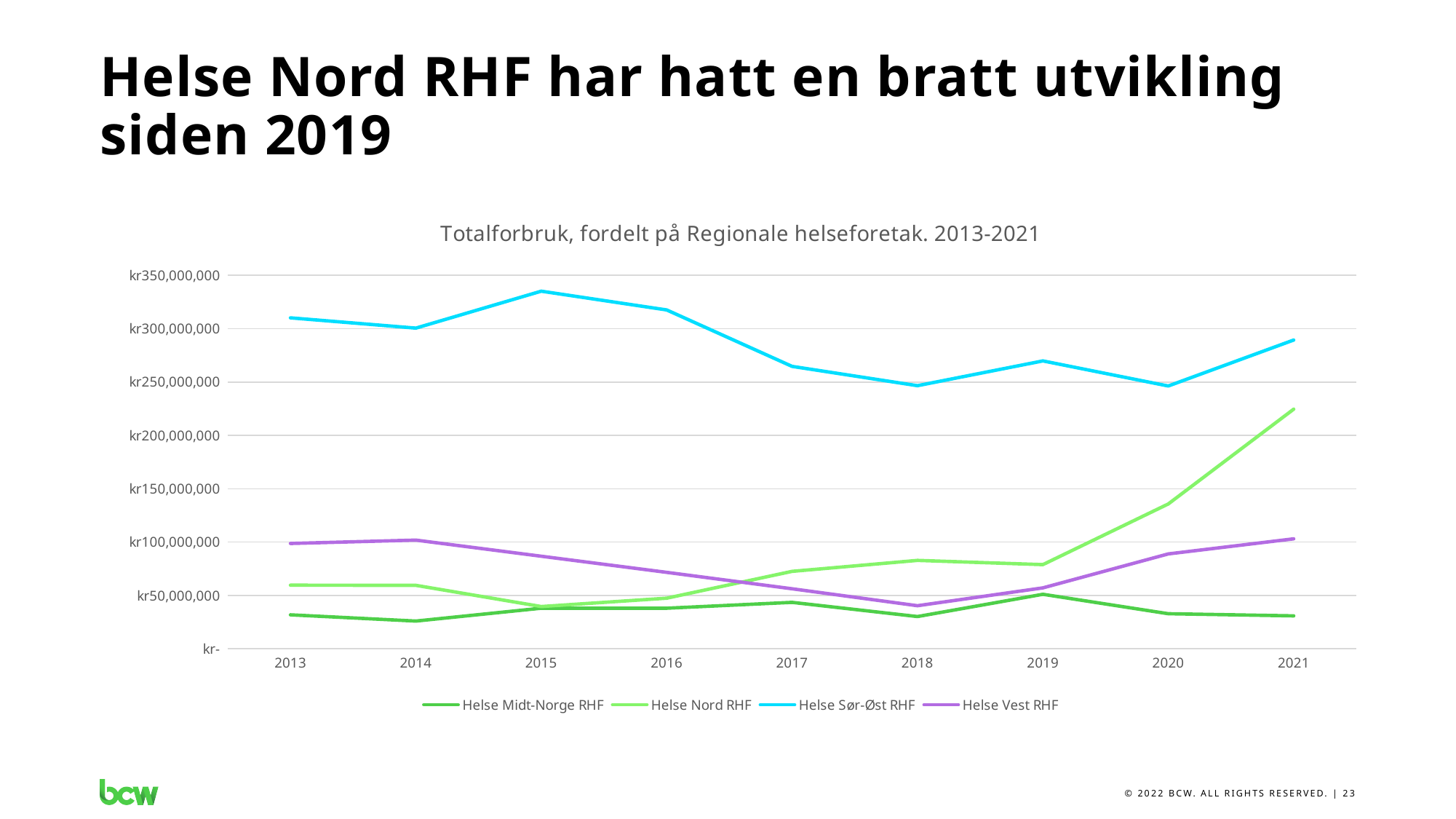
Is the value for Helse Vest RHF in 2018 greater or less than kr50,000,000? less How many series does the legend list? 4 In which year does Helse Sør-Øst RHF reach its highest value? 2015 What is the title of the chart? Totalforbruk, fordelt på Regionale helseforetak. 2013-2021 Does the line for Helse Nord RHF rise or fall from 2019 to 2021? Rise How many years are shown along the x axis? 9 Which regional health authority has the highest total spending in 2021? Helse Sør-Øst RHF Is the value for Helse Nord RHF in 2021 greater or less than kr200,000,000? greater In 2013, which is larger: the value for Helse Vest RHF or the value for Helse Nord RHF? Helse Vest RHF What kind of chart is shown on the slide? Line chart Which regional health authority has the lowest total spending in 2021? Helse Midt-Norge RHF Is the value for Helse Sør-Øst RHF in 2015 greater or less than kr300,000,000? greater